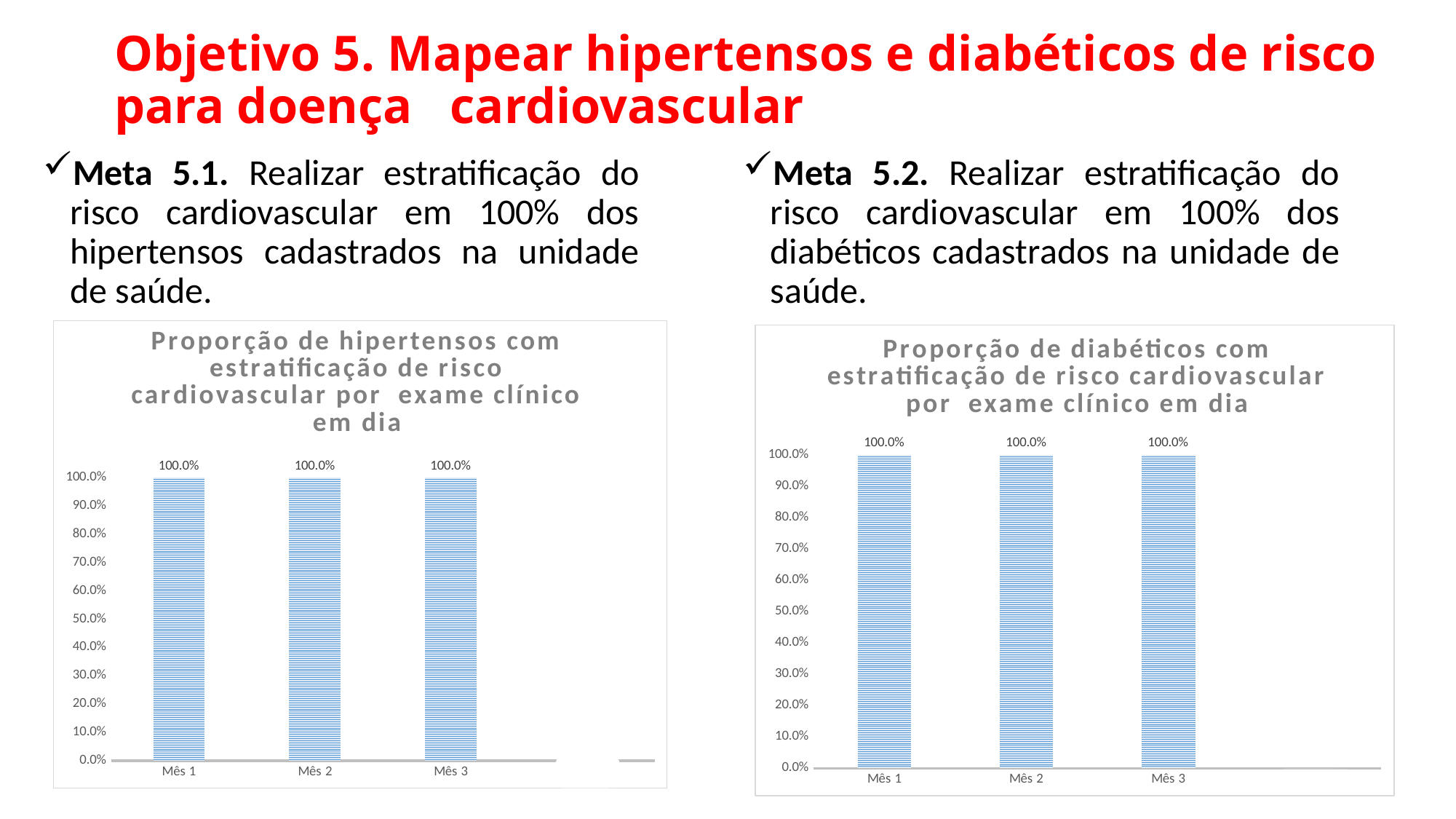
In the left chart (Proporção de hipertensos), is the value for Mês 2 greater or less than 50.0%? greater In the right chart (Proporção de diabéticos), what is the value for Mês 3? 100.0% How many categories are shown on the x axis of the right chart (Proporção de diabéticos)? 3 What kind of chart is the right chart (Proporção de diabéticos)? Bar chart In the right chart (Proporção de diabéticos), what is the difference between the values for Mês 3 and Mês 1? 0.0% In the left chart (Proporção de hipertensos), what is the value for Mês 3? 100.0% How many categories are shown on the x axis of the left chart (Proporção de hipertensos)? 3 In the right chart (Proporção de diabéticos com estratificação de risco cardiovascular por exame clínico em dia), what is the value for Mês 2? 100.0% In the right chart (Proporção de diabéticos), is the value for Mês 1 greater or less than 90.0%? greater In the left chart (Proporção de hipertensos), do the values rise, fall or stay the same from Mês 1 to Mês 3? Stay the same In the left chart (Proporção de hipertensos com estratificação de risco cardiovascular por exame clínico em dia), what is the value for Mês 1? 100.0% In the left chart (Proporção de hipertensos), what is the difference between the values for Mês 1 and Mês 2? 0.0%